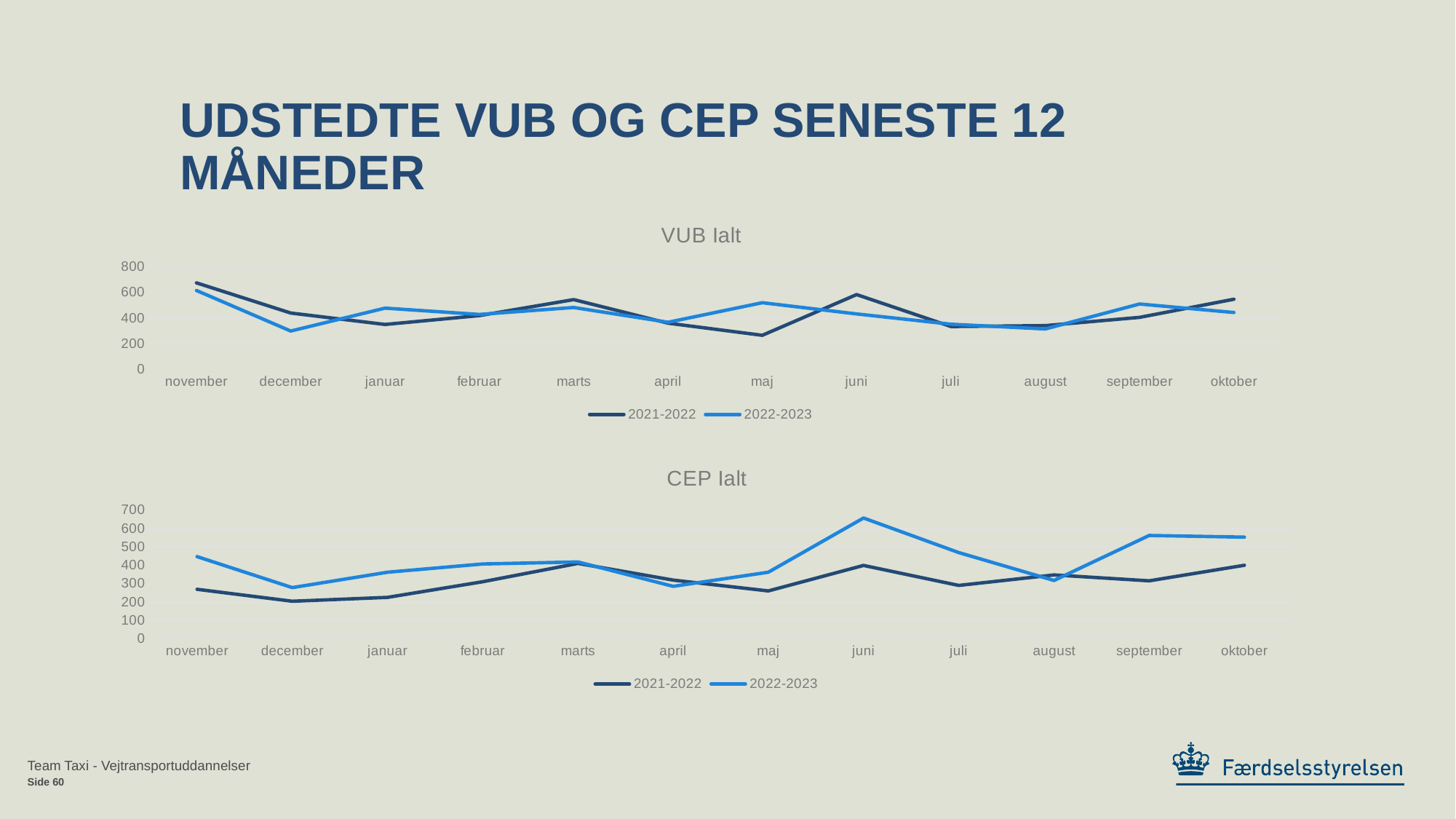
In the "CEP Ialt" chart, which month has the highest value for the 2022-2023 series? juni How many months are shown on the x axis of the "CEP Ialt" chart? 12 In the "CEP Ialt" chart, is the 2022-2023 value for juni greater or less than 600? greater In the "VUB Ialt" chart, is the 2021-2022 value for november greater or less than 600? greater In the "CEP Ialt" chart, which month has the lowest value for the 2021-2022 series? december In the "CEP Ialt" chart, which series has the larger value in juni, 2021-2022 or 2022-2023? 2022-2023 What kind of chart is the "VUB Ialt" chart? line chart In the "VUB Ialt" chart, which month has the highest value for the 2021-2022 series? november What are the two series listed in the legend of the "CEP Ialt" chart? 2021-2022 and 2022-2023 In the "VUB Ialt" chart, which month has the lowest value for the 2022-2023 series? december In the "CEP Ialt" chart, is the 2021-2022 value for december greater or less than 300? less How many series does the legend of the "VUB Ialt" chart list? 2